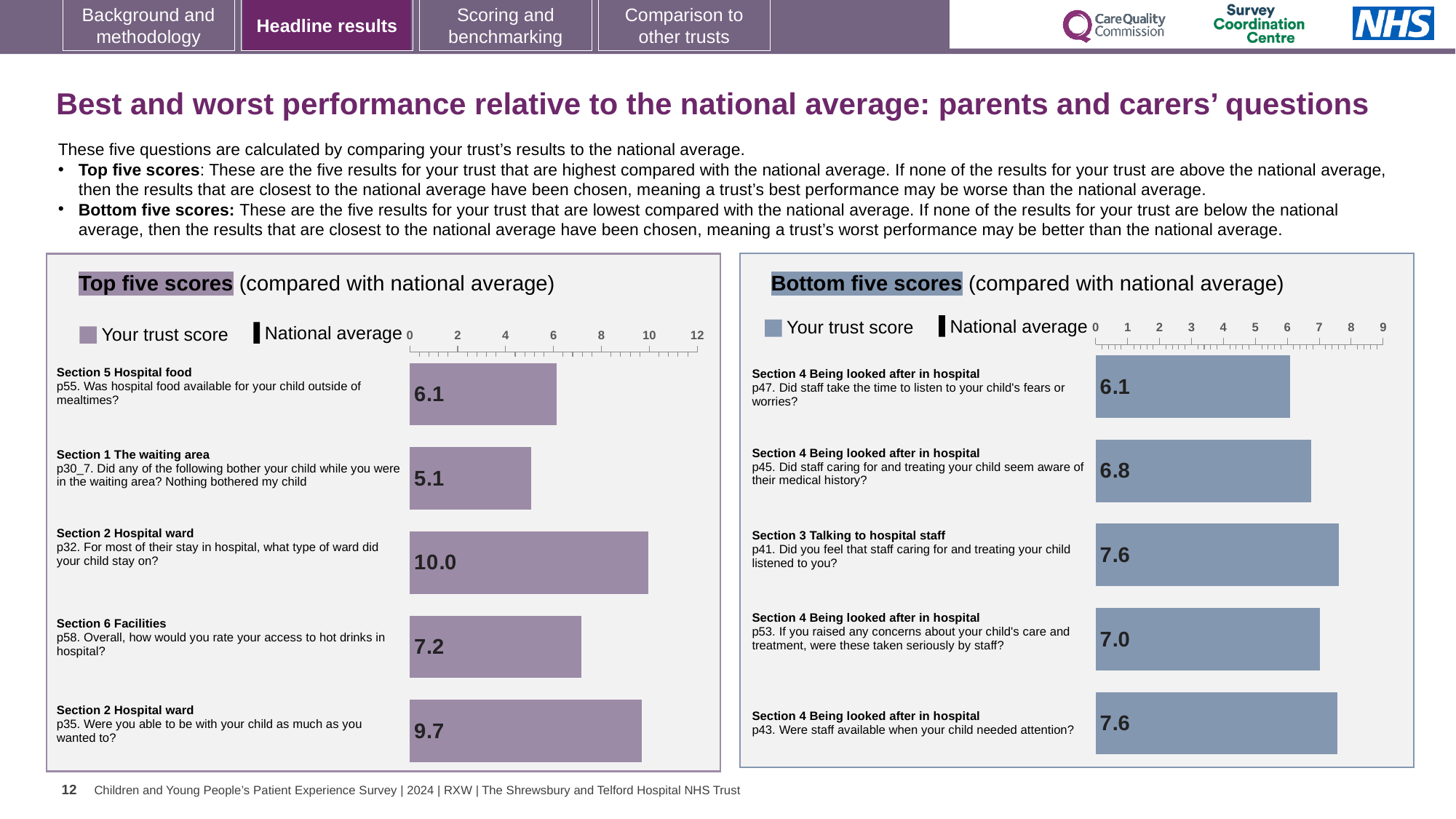
What kind of chart is the 'Top five scores' chart? Bar chart In the 'Bottom five scores' chart, which has the larger trust score: p45 or p53? p53 In the 'Top five scores' chart, which question has the highest trust score? p32. For most of their stay in hospital, what type of ward did your child stay on? In the 'Bottom five scores' chart, what is the trust score for p53 (concerns taken seriously by staff)? 7.0 In the 'Top five scores' chart, which question has the lowest trust score? p30_7. Did any of the following bother your child while you were in the waiting area? Nothing bothered my child In the 'Top five scores' chart, what is the trust score for p32 (what type of ward did your child stay on)? 10.0 How many series does the legend of the 'Top five scores' chart list? 2 In the 'Bottom five scores' chart, what is the trust score for p45 (staff aware of medical history)? 6.8 In the 'Top five scores' chart, what is the difference between the trust scores for p32 and p35? 0.3 In the 'Bottom five scores' chart, which question has the lowest trust score? p47. Did staff take the time to listen to your child's fears or worries? How many questions are shown in the 'Bottom five scores' chart? 5 In the 'Top five scores' chart, what is the trust score for p55 (hospital food available outside of mealtimes)? 6.1